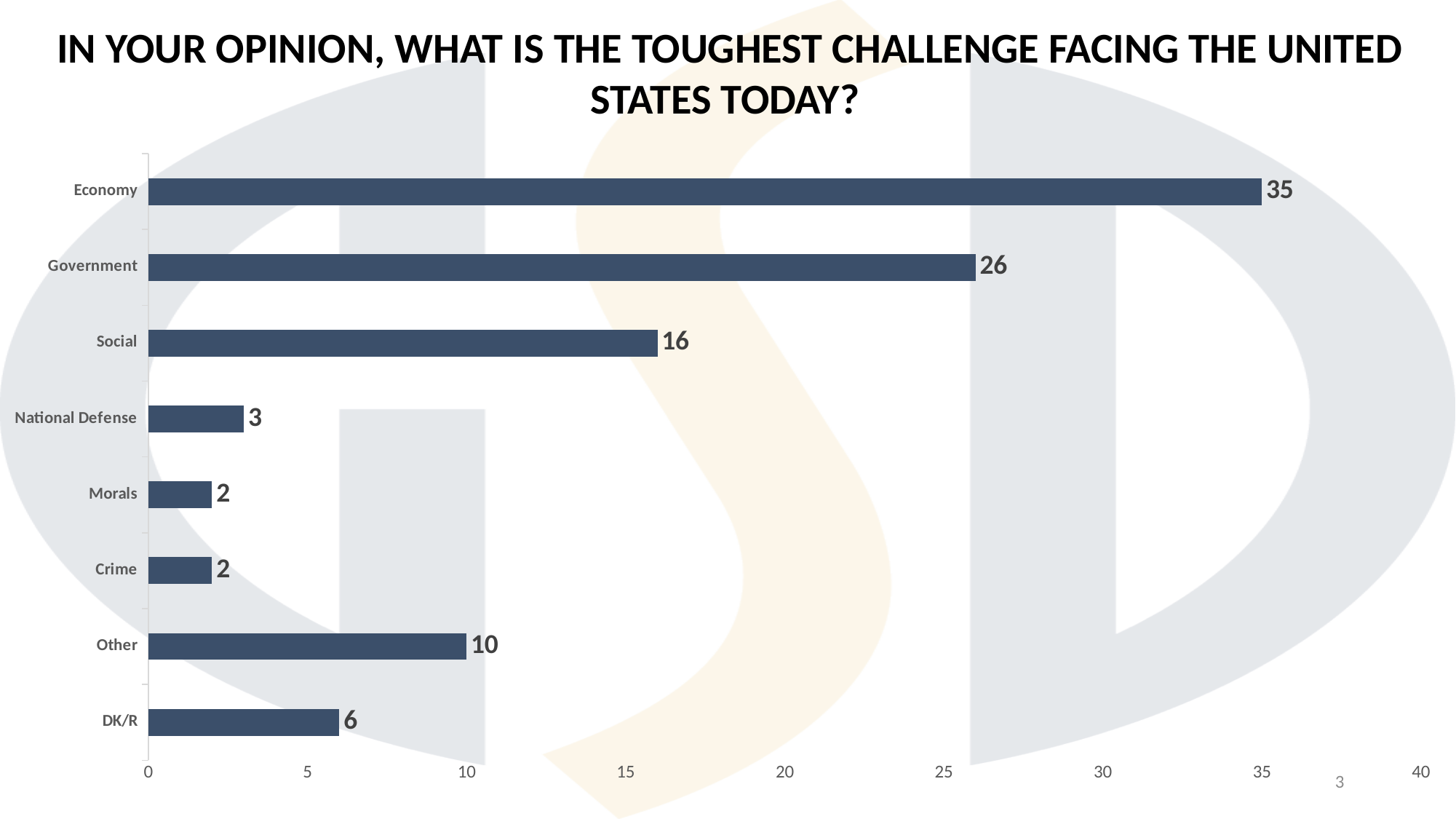
Is the value for Government greater or less than 25? greater What is the value for Social? 16 Which category has the highest value? Economy What is the value for Economy? 35 How many categories are shown in the chart? 8 What is the title of the chart? In your opinion, what is the toughest challenge facing the United States today? Which is larger, the value for National Defense or the value for Morals? National Defense What kind of chart is shown on the slide? Bar chart What is the difference between the values for Social and Other? 6 What is the difference between the values for Economy and Government? 9 What is the value for DK/R? 6 Which is larger, the value for Other or the value for DK/R? Other